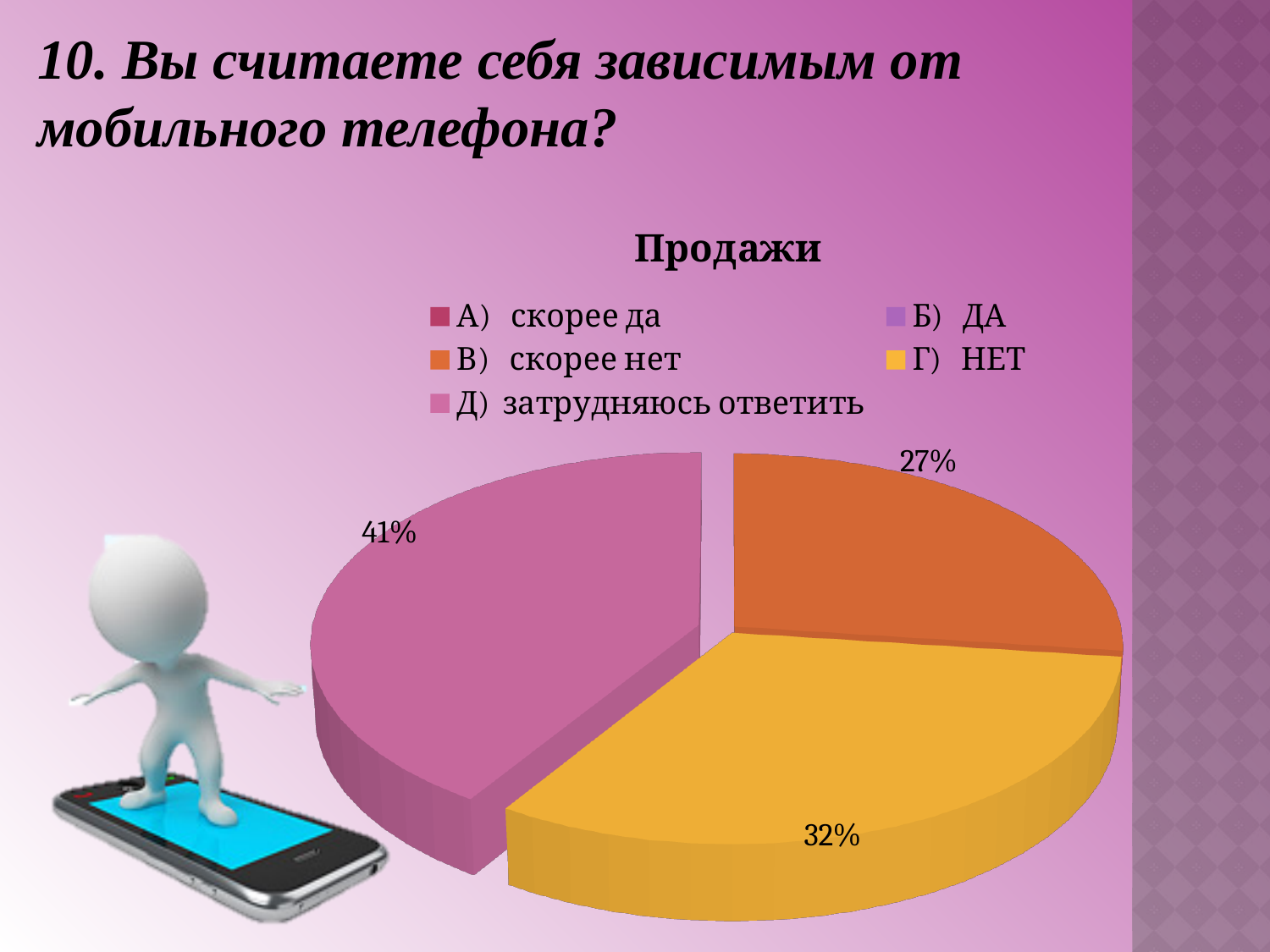
What share of the pie does the slice for "Д) затрудняюсь ответить" represent? 41% What type of chart is shown on the slide? pie chart Which of the labelled slices is the smallest? В) скорее нет How many entries does the chart legend list? 5 What share of the pie does the slice for "Г) НЕТ" represent? 32% Which answer option has the largest slice of the pie? Д) затрудняюсь ответить What is the difference in percentage points between the slices for "Д) затрудняюсь ответить" and "В) скорее нет"? 14 What is the difference in percentage points between the slices for "Г) НЕТ" and "В) скорее нет"? 5 How many slices with percentage labels are visible in the pie? 3 What is the title of the chart? Продажи Which slice is larger, "Г) НЕТ" or "В) скорее нет"? Г) НЕТ What share of the pie does the slice for "В) скорее нет" represent? 27%